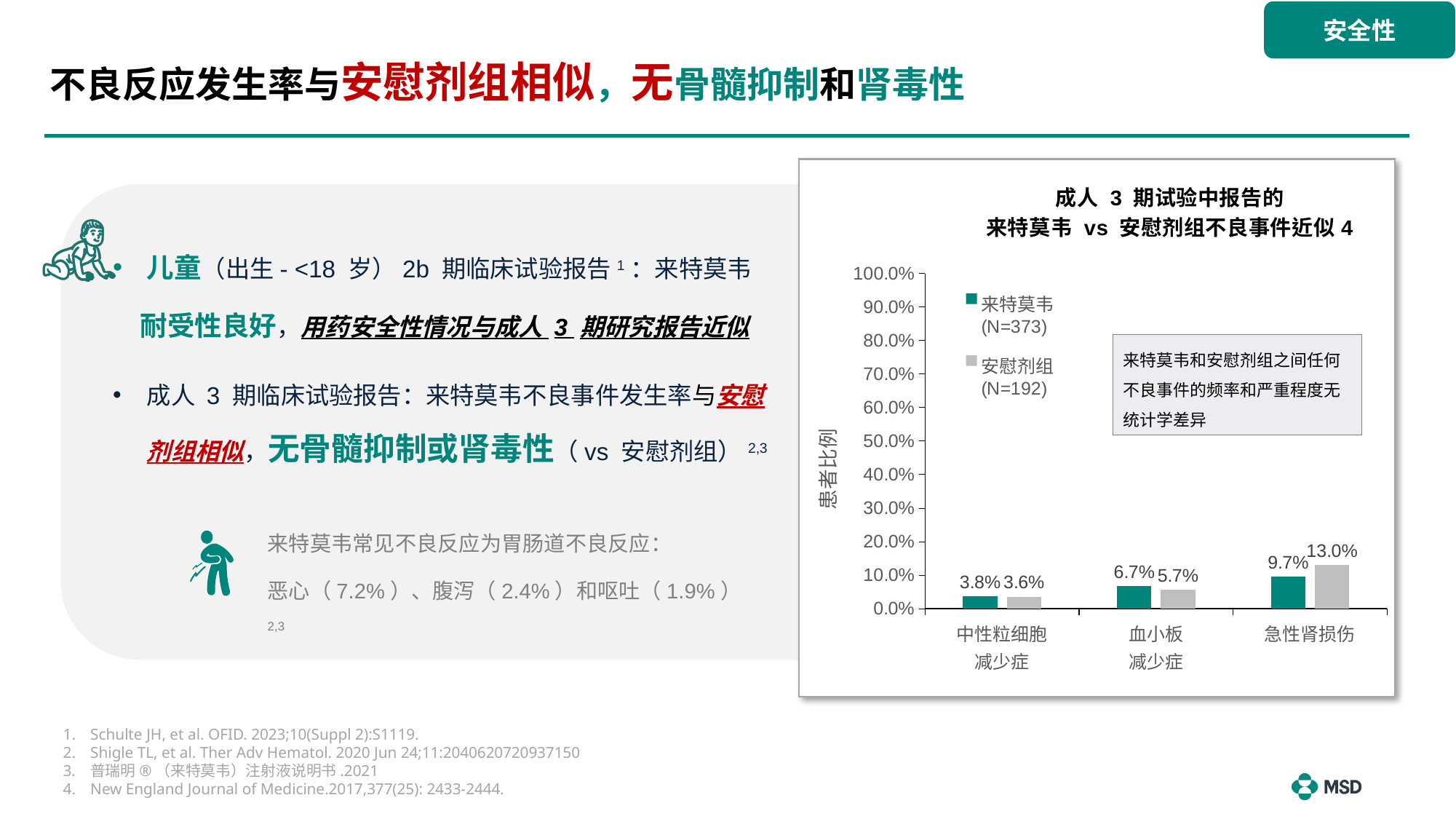
What is the difference between the 安慰剂组 and 来特莫韦 values in the 急性肾损伤 category? 3.3% Is the value for 安慰剂组 in the 急性肾损伤 category greater or less than 10.0%? greater What is the value for 来特莫韦 in the 中性粒细胞减少症 category? 3.8% Which category has the lowest value for 来特莫韦? 中性粒细胞减少症 Which category has the highest value for 安慰剂组? 急性肾损伤 What is the value for 安慰剂组 in the 血小板减少症 category? 5.7% What kind of chart is shown on the slide? bar chart What is the value for 来特莫韦 in the 急性肾损伤 category? 9.7% How many categories are shown on the x axis of the chart? 3 In the 血小板减少症 category, which series has the larger value, 来特莫韦 or 安慰剂组? 来特莫韦 What is the sample size (N) shown in the legend for 安慰剂组? N=192 How many series does the chart legend list? 2